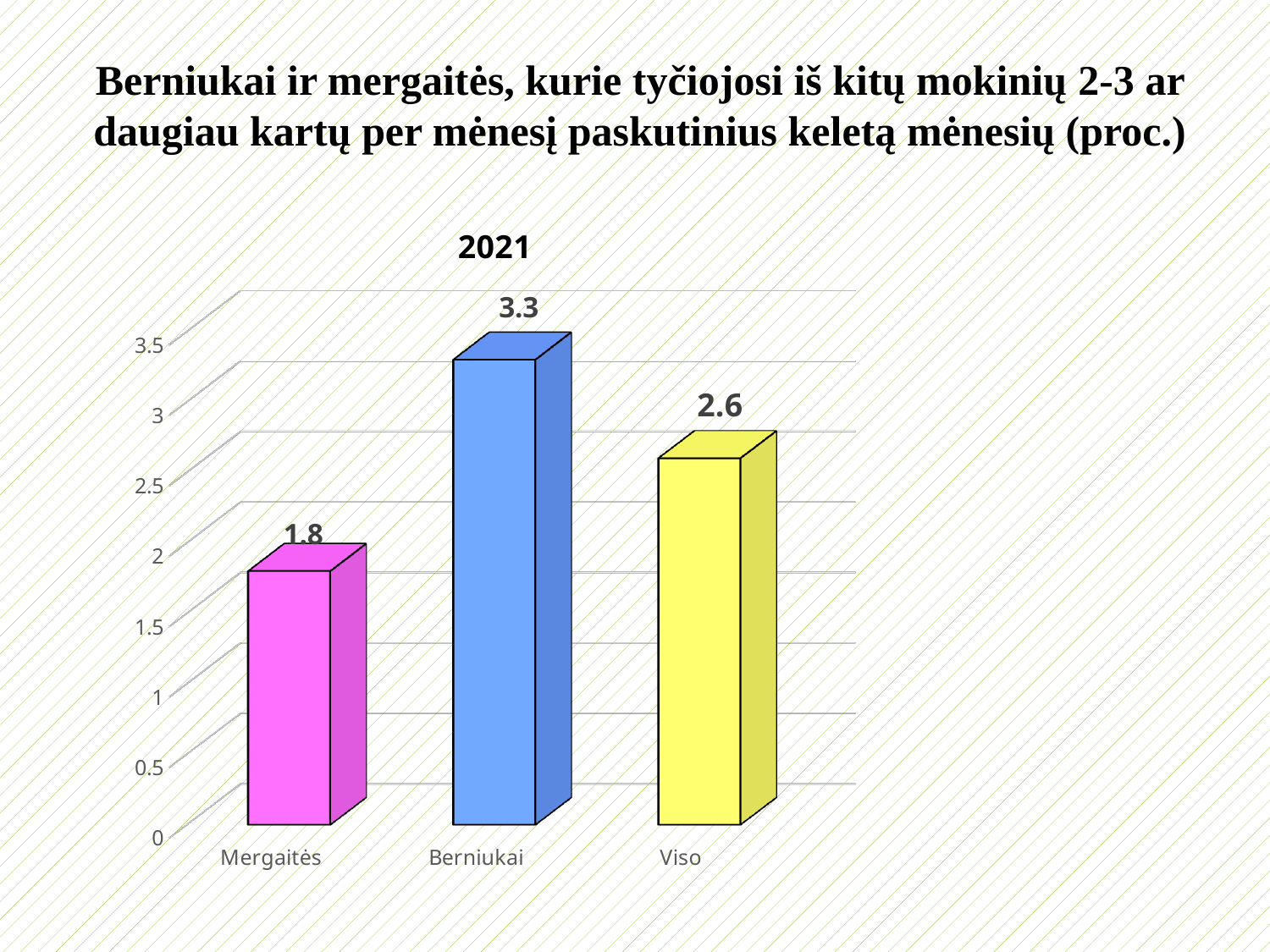
What is the title shown above the chart's plot area? 2021 What is the value for Viso? 2.6 Which category has the lowest value? Mergaitės What is the difference between the values for Berniukai and Mergaitės? 1.5 What is the value for Mergaitės? 1.8 What is the value for Berniukai? 3.3 How many categories are shown on the x axis? 3 Is the value for Berniukai greater or less than 3? greater What kind of chart is shown on the slide? bar chart Which category has the highest value? Berniukai Which is larger, the value for Viso or the value for Mergaitės? Viso What is the difference between the values for Berniukai and Viso? 0.7